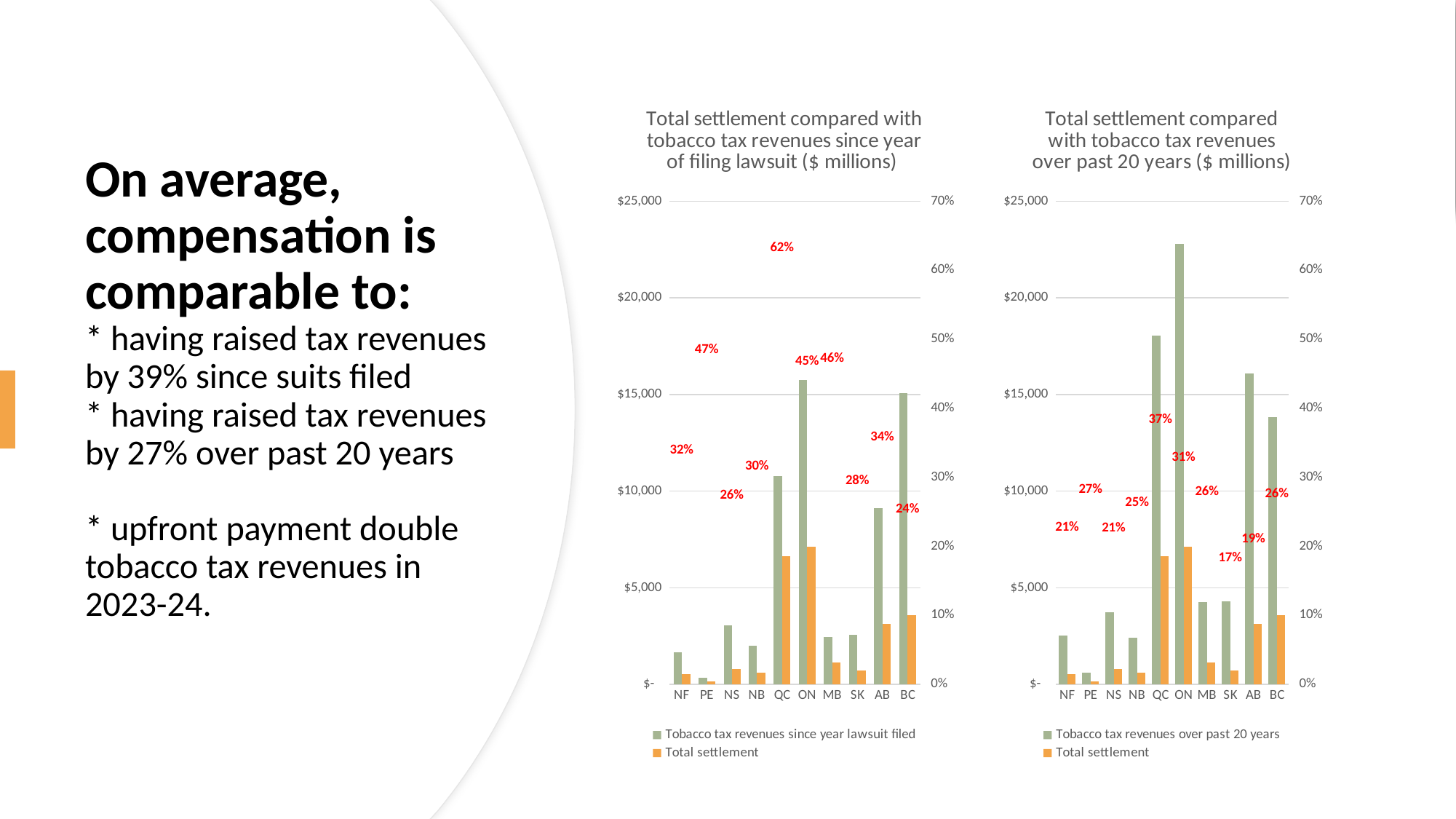
How many series does the legend of the left chart list? 2 How many provinces are shown on the x axis of the right chart, 'Total settlement compared with tobacco tax revenues over past 20 years'? 10 In the right chart (over past 20 years), what percentage label is shown for QC? 37% What kind of chart is the left chart, 'Total settlement compared with tobacco tax revenues since year of filing lawsuit'? Bar chart In the right chart (over past 20 years), which province has the lowest percentage label? SK In the left chart (since year of filing lawsuit), which province has the highest percentage label? QC In the left chart (since year of filing lawsuit), which has the larger percentage label, PE or NF? PE In the right chart (over past 20 years), which province has the tallest tobacco tax revenues bar? ON In the right chart (over past 20 years), is the tobacco tax revenues value for ON greater or less than $20,000? greater In the left chart (since year of filing lawsuit), what percentage label is shown for QC? 62% In the left chart (since year of filing lawsuit), what is the difference between the percentage labels for QC and BC? 38% In the right chart, which series is shown in orange according to the legend? Total settlement